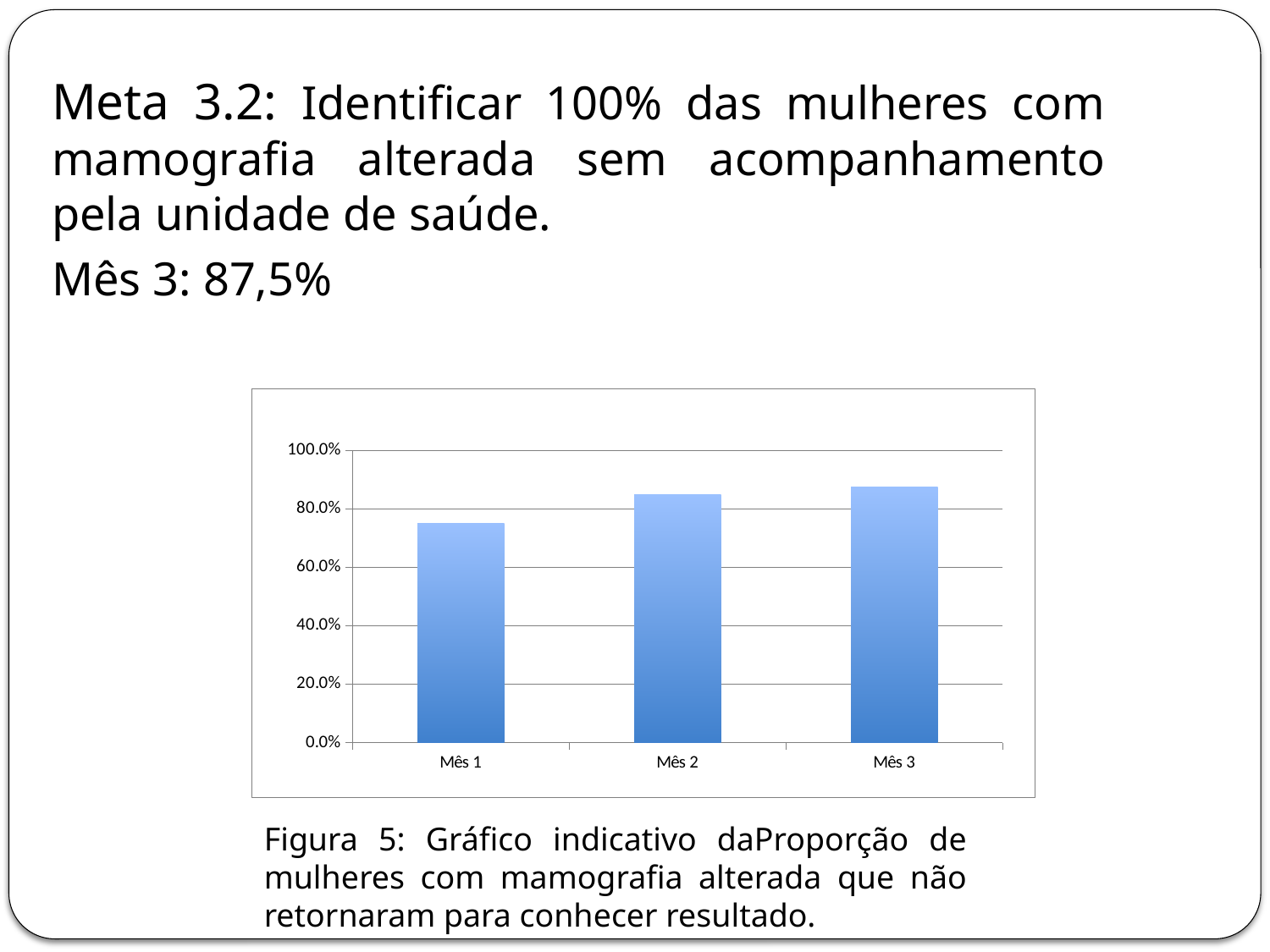
Do the values rise or fall from Mês 1 to Mês 3? rise Which is larger, the bar for Mês 1 or the bar for Mês 2? Mês 2 Is the bar for Mês 2 greater or less than 80.0%? greater What is the highest tick value shown on the vertical axis? 100.0% According to the slide text, what is the value for Mês 3? 87,5% Is the bar for Mês 1 greater or less than 80.0%? less How many categories (months) are plotted on the chart? 3 Is the bar for Mês 1 greater or less than 60.0%? greater What figure number is given in the caption below the chart? Figura 5 Which month has the lowest bar on the chart? Mês 1 What kind of chart is shown on the slide? bar chart